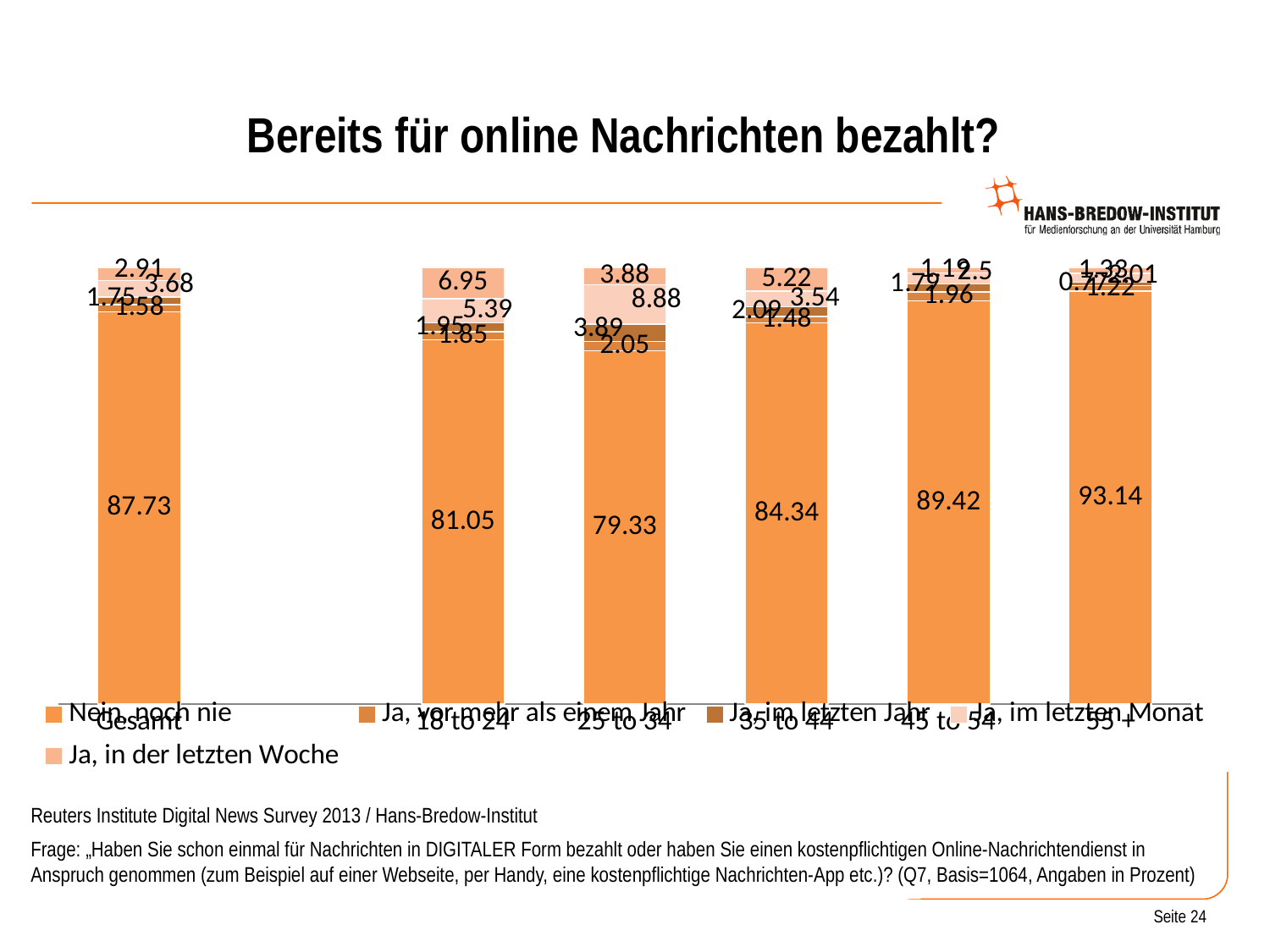
What is the value of "Nein, noch nie" for the 55+ age group? 93.14 What is the difference between the "Nein, noch nie" values for 55+ and 25 to 34? 13.81 How many categories are shown on the x axis? 6 Which age group has the lowest value for "Nein, noch nie"? 25 to 34 Which age group has the highest value for "Nein, noch nie"? 55+ What is the title of the chart? Bereits für online Nachrichten bezahlt? What is the value of "Nein, noch nie" for the 25 to 34 age group? 79.33 Which has a larger "Nein, noch nie" value, 35 to 44 or 45 to 54? 45 to 54 How many series does the legend list? 5 What is the value of "Nein, noch nie" for the Gesamt category? 87.73 What kind of chart is shown on the slide? stacked bar chart What is the value of "Nein, noch nie" for the 18 to 24 age group? 81.05